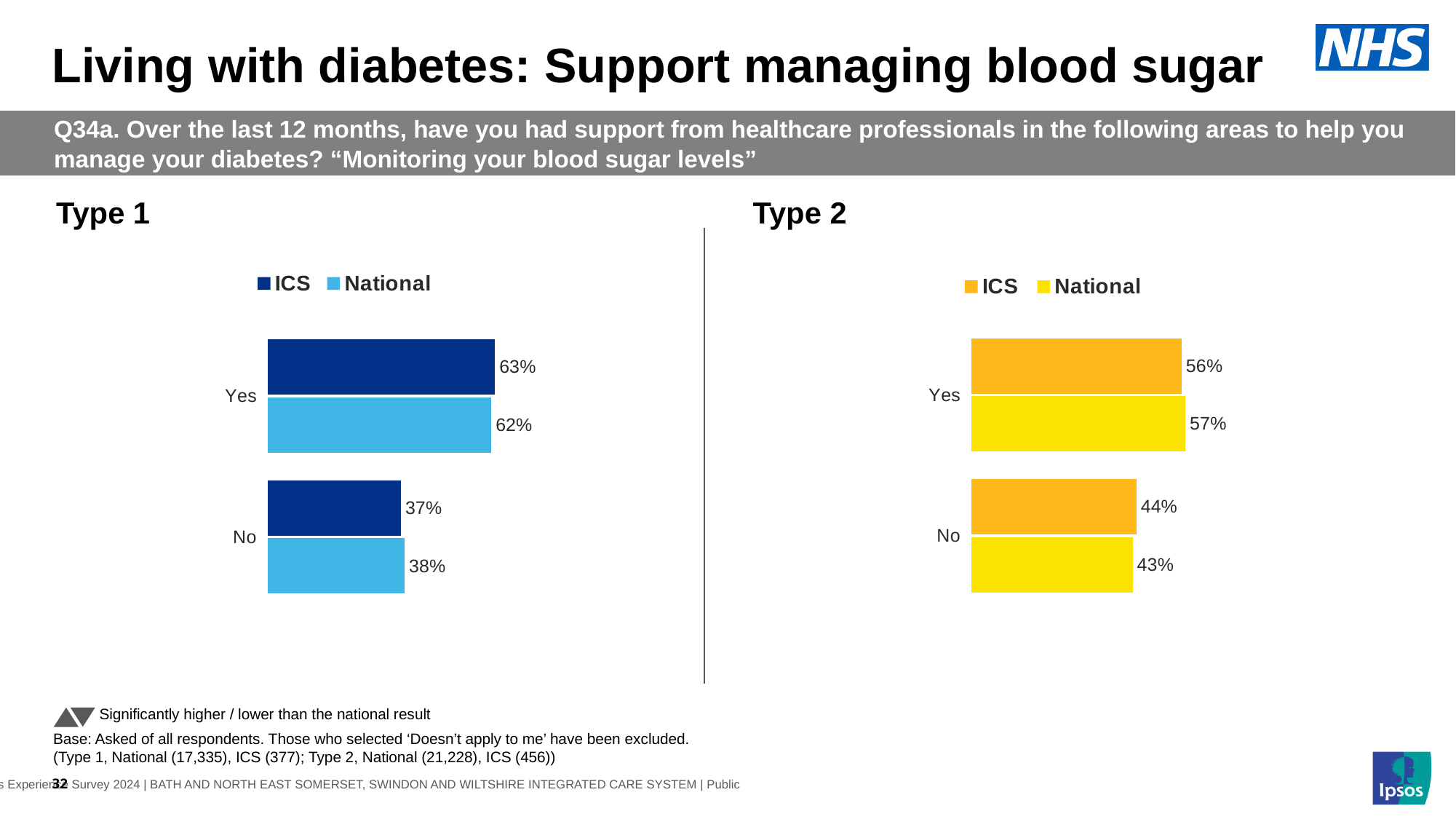
In the Type 1 chart, what is the National value for No? 38% What are the two legend entries in the Type 1 chart? ICS and National How many categories are shown in the Type 1 chart? 2 What kind of chart is the Type 1 chart? Bar chart In the Type 2 chart, what is the National value for No? 43% In the Type 2 chart, what is the difference between the ICS and National values for Yes? 1% How many series does the legend of the Type 2 chart list? 2 In the Type 2 chart, what is the ICS value for Yes? 56% In the Type 1 chart, which is larger for ICS: Yes or No? Yes In the Type 2 chart, which category has the lowest National value? No In the Type 1 chart, what is the ICS value for Yes? 63% In the Type 1 chart, what is the difference between the ICS values for Yes and No? 26%